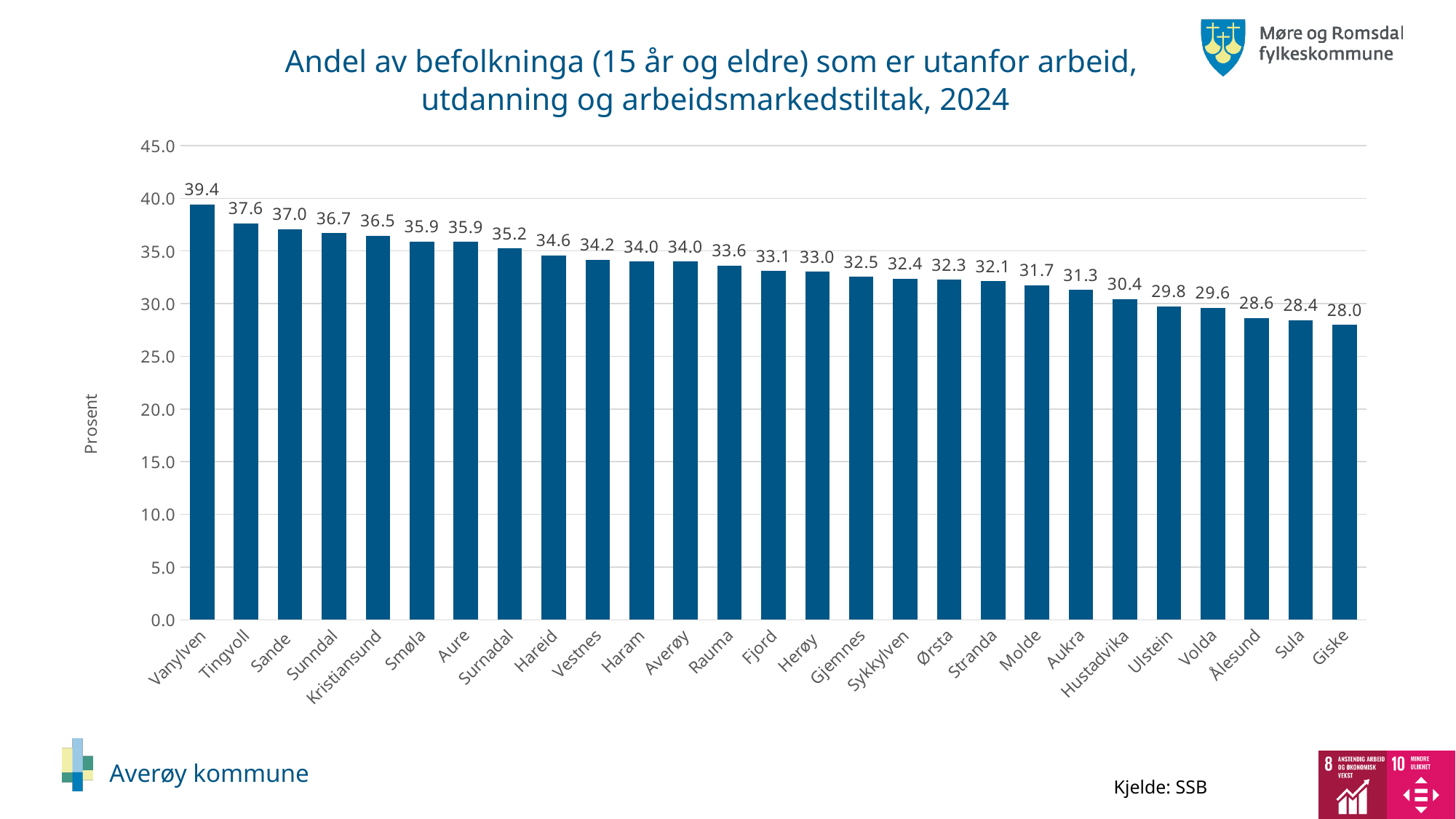
What is the difference between the values for Vanylven and Giske? 11.4 What is the value for Averøy? 34.0 What is the value for Kristiansund? 36.5 Is the value for Sula greater or less than 30.0? less What is the value for Molde? 31.7 Which municipality has the highest value? Vanylven What is the difference between the values for Tingvoll and Sande? 0.6 Which has a larger value, Hareid or Ulstein? Hareid What kind of chart is shown? bar chart How many municipalities are shown on the chart? 27 Which municipality has the lowest value? Giske What is the label on the vertical axis? Prosent